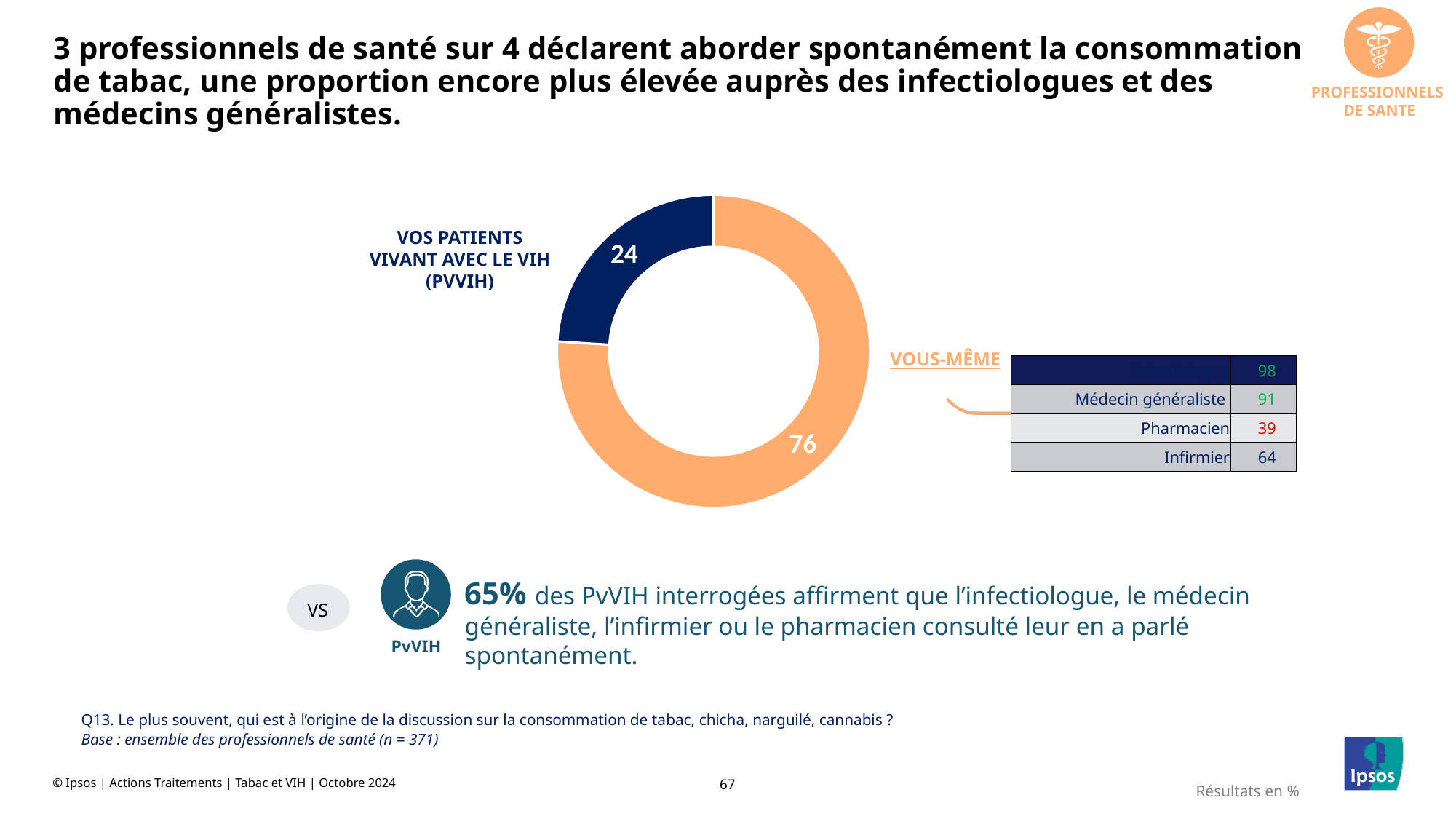
How many slices does the donut chart have? 2 Which slice of the donut chart is the smallest? VOS PATIENTS VIVANT AVEC LE VIH (PVVIH) What is the value for "VOUS-MÊME" in the donut chart? 76 Which slice of the donut chart is the largest? VOUS-MÊME What colour is the "VOUS-MÊME" slice of the donut chart? Orange In the table next to the donut chart, what is the value for "Médecin généraliste"? 91 What is the value for "VOS PATIENTS VIVANT AVEC LE VIH (PVVIH)" in the donut chart? 24 What kind of chart is shown on the slide? Donut chart What is the difference between the "VOUS-MÊME" slice and the "VOS PATIENTS VIVANT AVEC LE VIH (PVVIH)" slice in the donut chart? 52 In the table next to the donut chart, what is the value for "Pharmacien"? 39 What colour is the "VOS PATIENTS VIVANT AVEC LE VIH (PVVIH)" slice of the donut chart? Dark blue Which is larger in the donut chart: "VOUS-MÊME" or "VOS PATIENTS VIVANT AVEC LE VIH (PVVIH)"? VOUS-MÊME